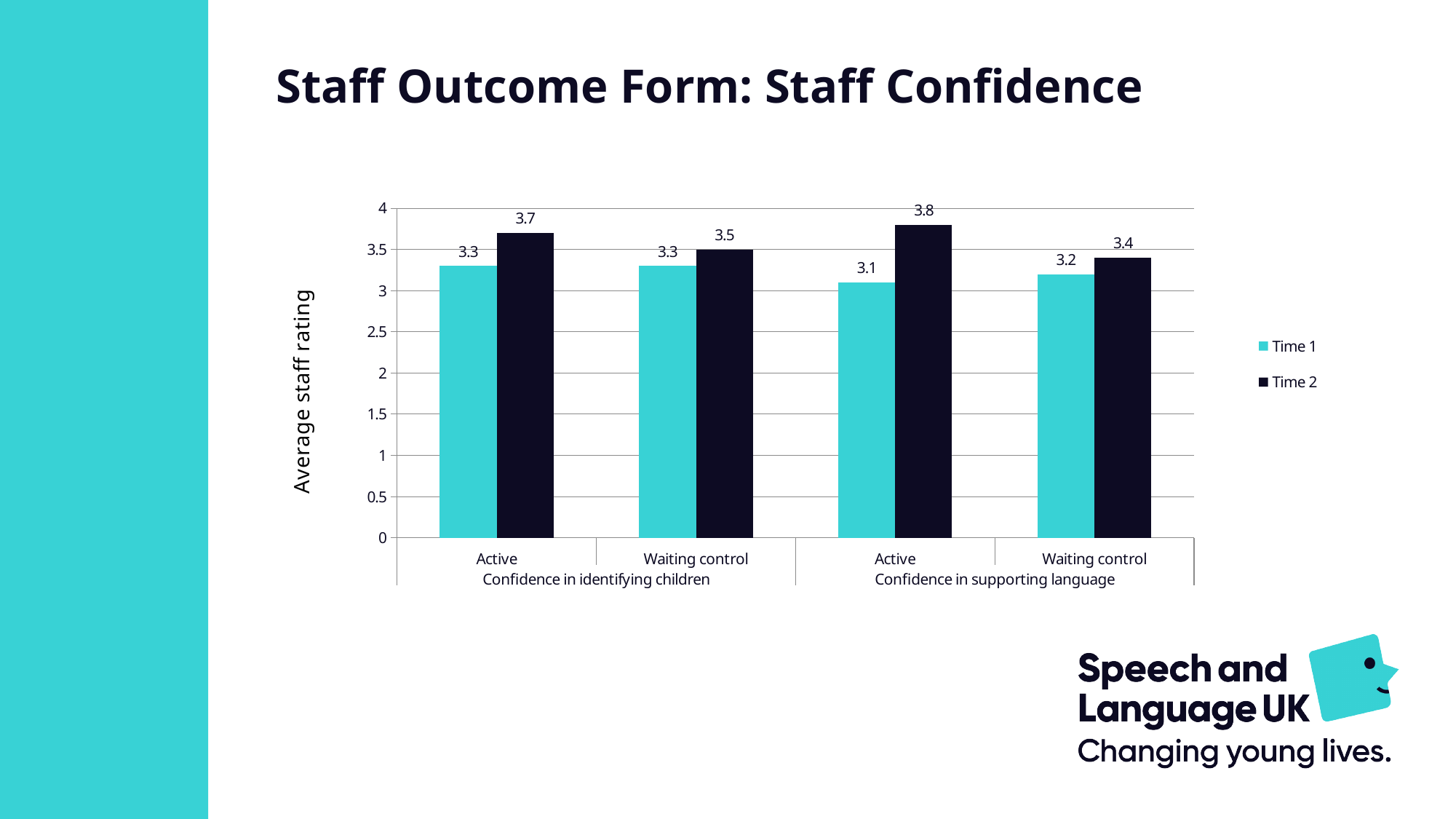
Which bar has the lowest value on the chart? Time 1, Active, Confidence in supporting language (3.1) Which is larger: the Time 2 value for Active under Confidence in identifying children or the Time 2 value for Waiting control under Confidence in supporting language? Active under Confidence in identifying children (3.7) Which bar has the highest value on the chart? Time 2, Active, Confidence in supporting language (3.8) How many series does the legend list? 2 What is the difference between Time 2 and Time 1 for Waiting control under Confidence in identifying children? 0.2 What kind of chart is shown on the slide? Bar chart What is the Time 1 value for Active under Confidence in identifying children? 3.3 What is the Time 2 value for Waiting control under Confidence in identifying children? 3.5 What is the label of the vertical axis? Average staff rating What is the Time 1 value for Waiting control under Confidence in supporting language? 3.2 What is the Time 2 value for Active under Confidence in supporting language? 3.8 What is the difference between Time 2 and Time 1 for Active under Confidence in supporting language? 0.7